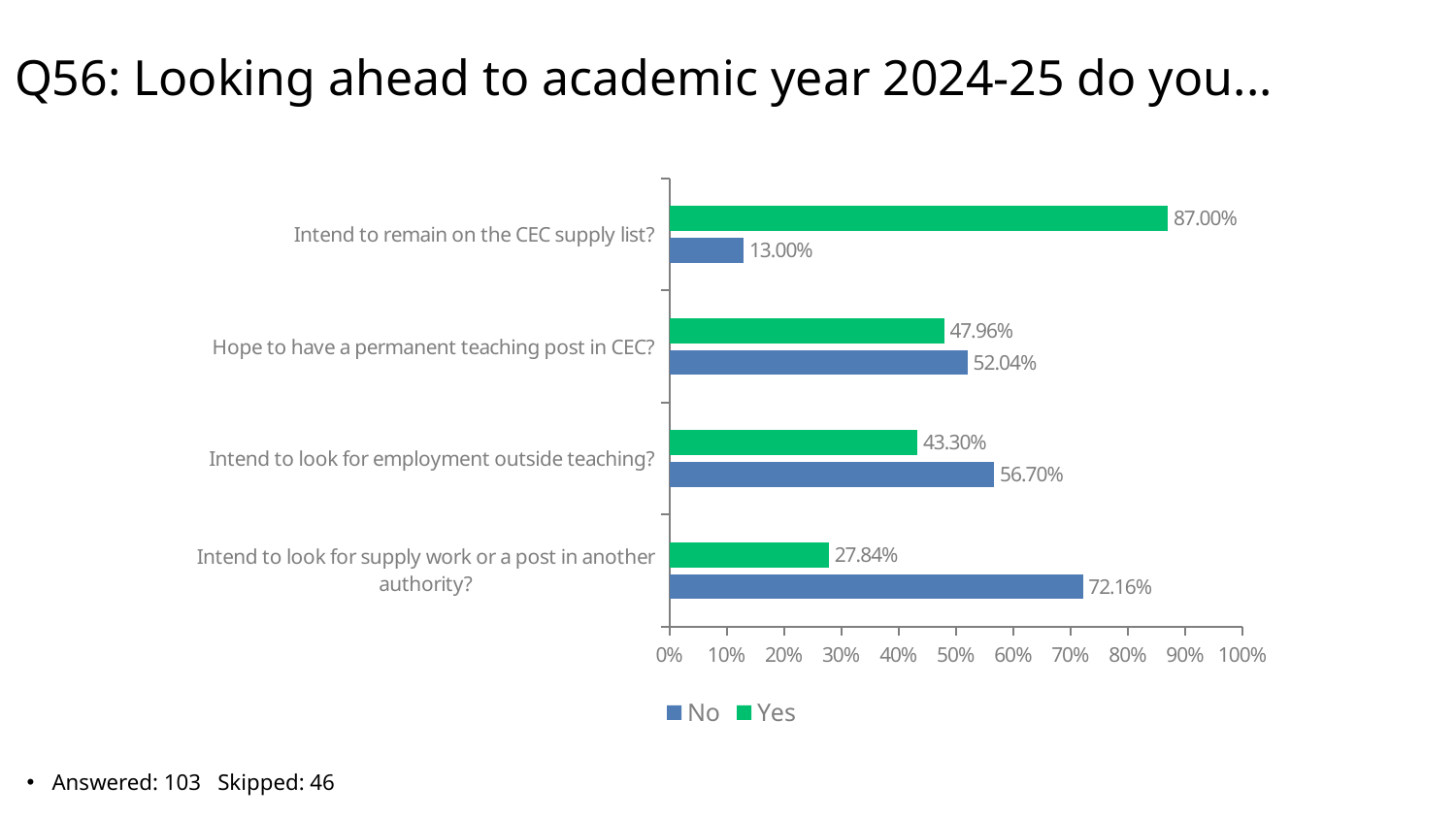
What is the difference between the No and Yes percentages for 'Intend to look for supply work or a post in another authority?' 44.32% For 'Intend to look for employment outside teaching?', which is larger, the Yes or the No percentage? No What type of chart is shown on the slide? Bar chart How many series does the legend list? 2 Which colour represents the Yes series in the chart? Green How many questions (categories) are shown on the chart? 4 What percentage answered Yes to 'Intend to remain on the CEC supply list?' 87.00% Which question has the lowest No percentage? Intend to remain on the CEC supply list? What percentage answered Yes to 'Intend to look for employment outside teaching?' 43.30% Which question has the highest Yes percentage? Intend to remain on the CEC supply list? What percentage answered No to 'Hope to have a permanent teaching post in CEC?' 52.04% What percentage answered No to 'Intend to look for supply work or a post in another authority?' 72.16%